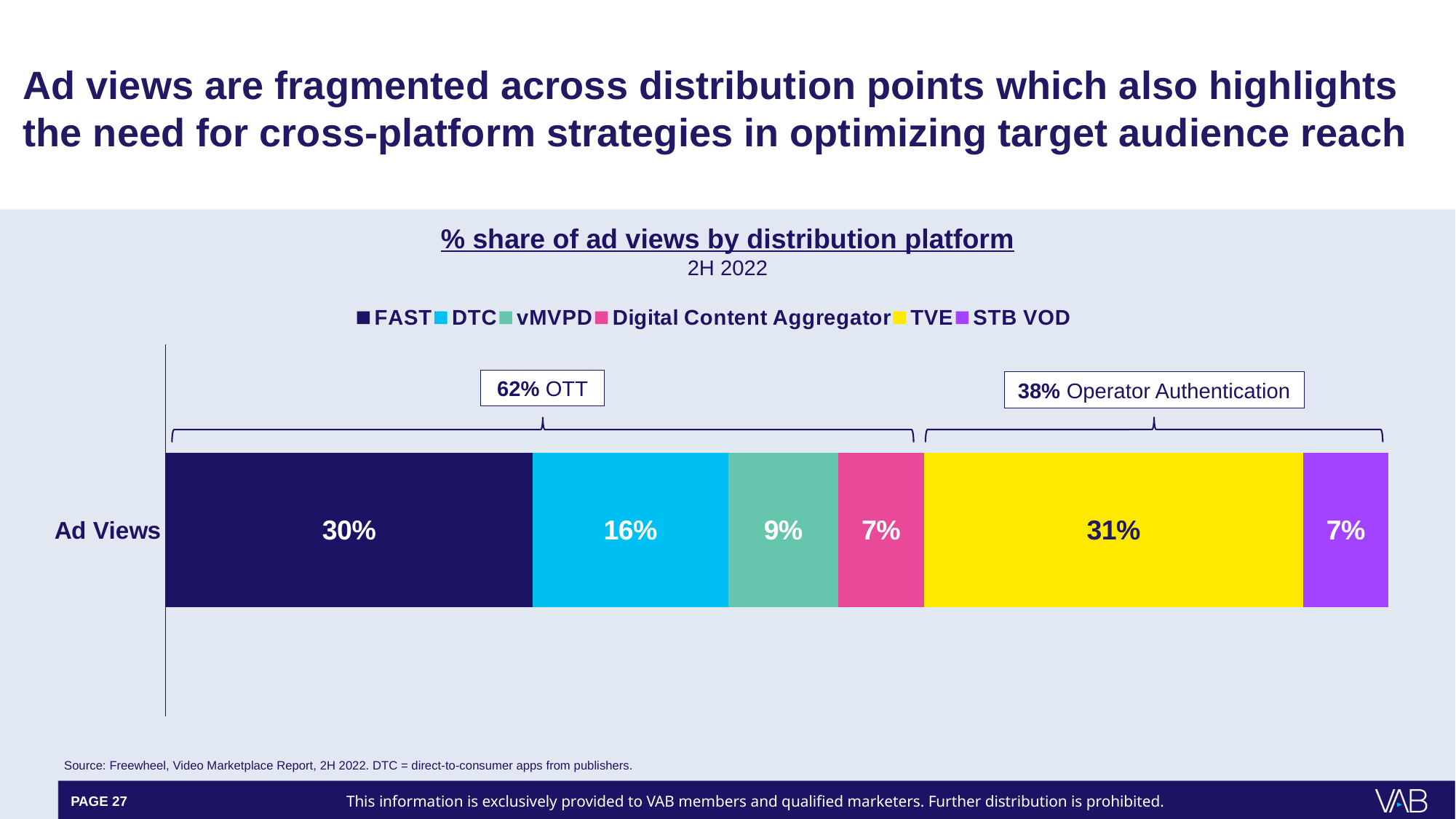
What is the share of ad views for TVE? 31% What is the combined share of ad views for the OTT platforms, as labelled on the chart? 62% What is the difference between the FAST share and the DTC share of ad views? 14% What is the title of the chart? % share of ad views by distribution platform What is the share of ad views for FAST? 30% Which distribution platform has the largest share of ad views? TVE Which has a larger share of ad views, DTC or vMVPD? DTC What is the share of ad views for vMVPD? 9% What is the share of ad views for DTC? 16% What kind of chart is shown on the slide? Stacked bar chart What is the difference between the TVE share and the FAST share of ad views? 1% How many series does the legend list? 6